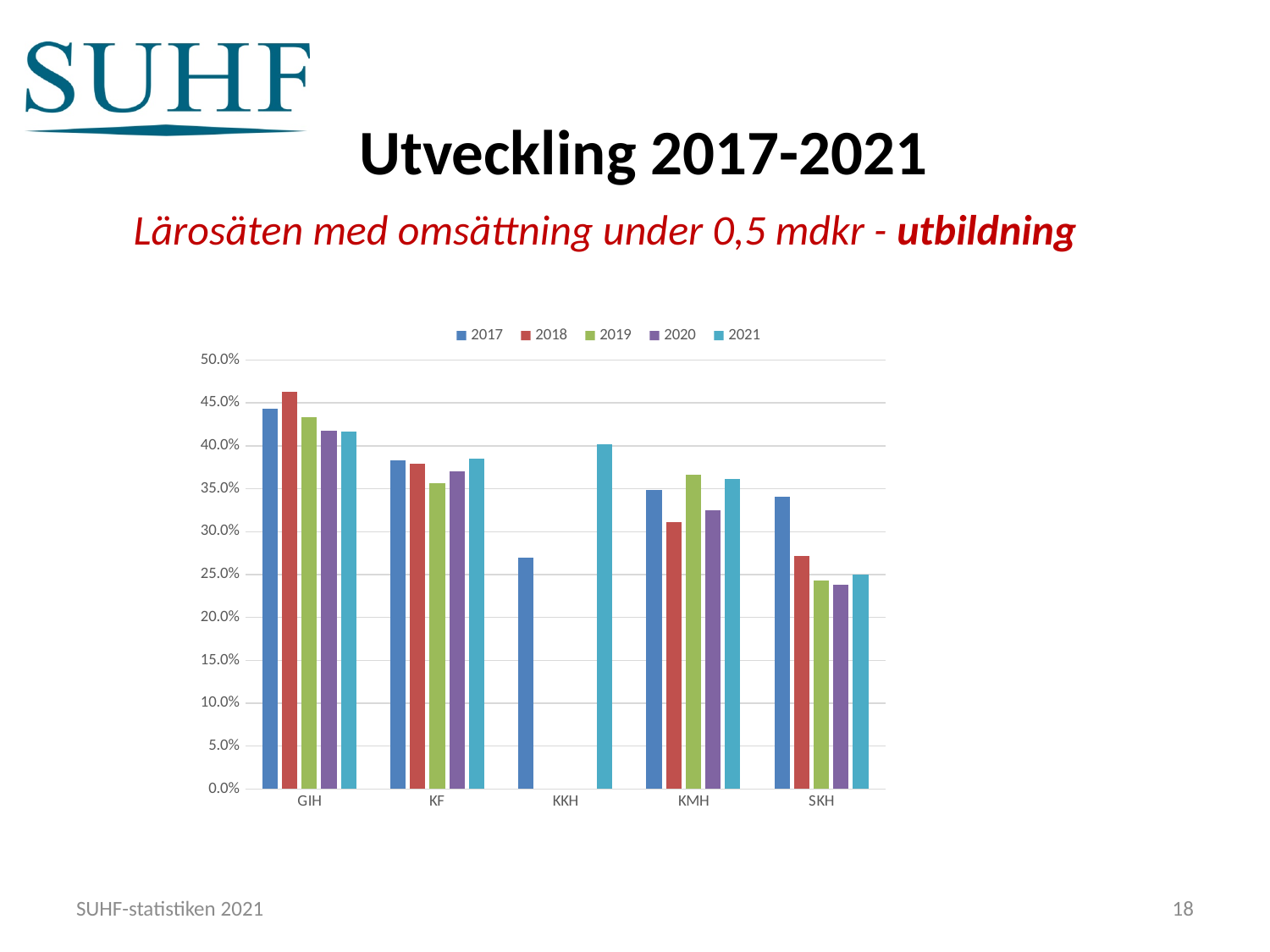
Which series is listed first in the legend? 2017 For SKH, which is larger: the value for 2017 or the value for 2018? 2017 How many series does the legend list? 5 Is the value for GIH in 2018 greater or less than 45.0%? greater Is the value for SKH in 2019 greater or less than 25.0%? less Which category has the lowest value for 2020? SKH For KMH, which is larger: the value for 2018 or the value for 2019? 2019 Which category has the highest value for 2018? GIH How many categories are shown on the x axis? 5 Is the value for KKH in 2017 greater or less than 30.0%? less What kind of chart is shown on the slide? bar chart Does the value for GIH rise or fall from 2018 to 2021? fall